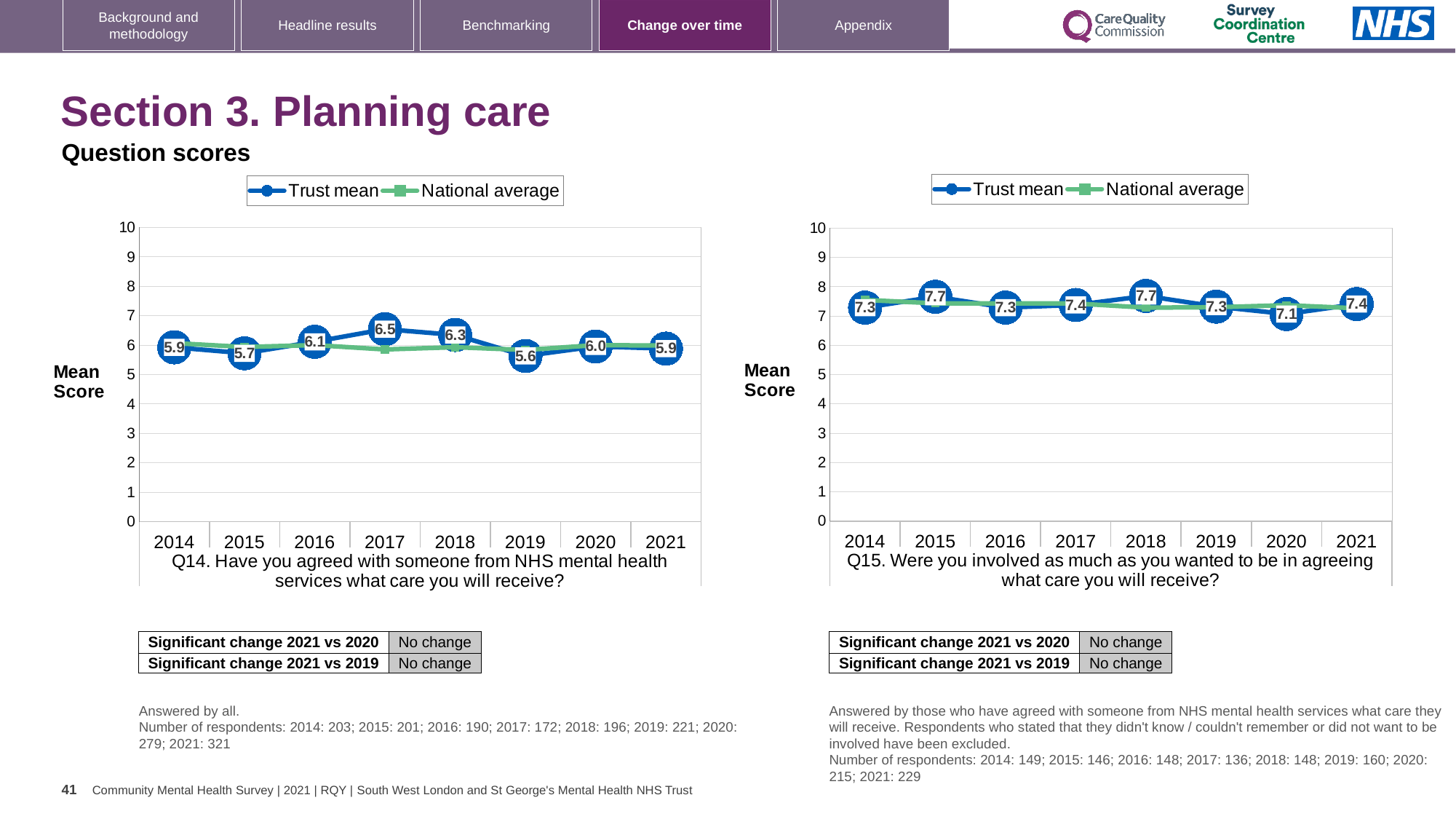
In the Q15 chart (right), what is the Trust mean score for 2020? 7.1 In the Q15 chart (right), is the National average value for 2014 greater or less than 7? greater In the Q14 chart (left), which year has the highest Trust mean score? 2017 In the Q15 chart (right), what is the difference between the Trust mean scores for 2015 and 2020? 0.6 How many years are plotted on the x axis of the Q14 chart (left)? 8 How many series does the legend of the Q15 chart (right) list? 2 In the Q14 chart (left), what is the difference between the Trust mean scores for 2017 and 2019? 0.9 In the Q14 chart (left), what is the Trust mean score for 2017? 6.5 What kind of chart is the Q14 chart (left)? Line chart In the Q14 chart (left), which year has the lowest Trust mean score? 2019 In the Q14 chart (left), is the Trust mean score higher in 2016 or in 2018? 2018 In the Q15 chart (right), which year has the lowest Trust mean score? 2020